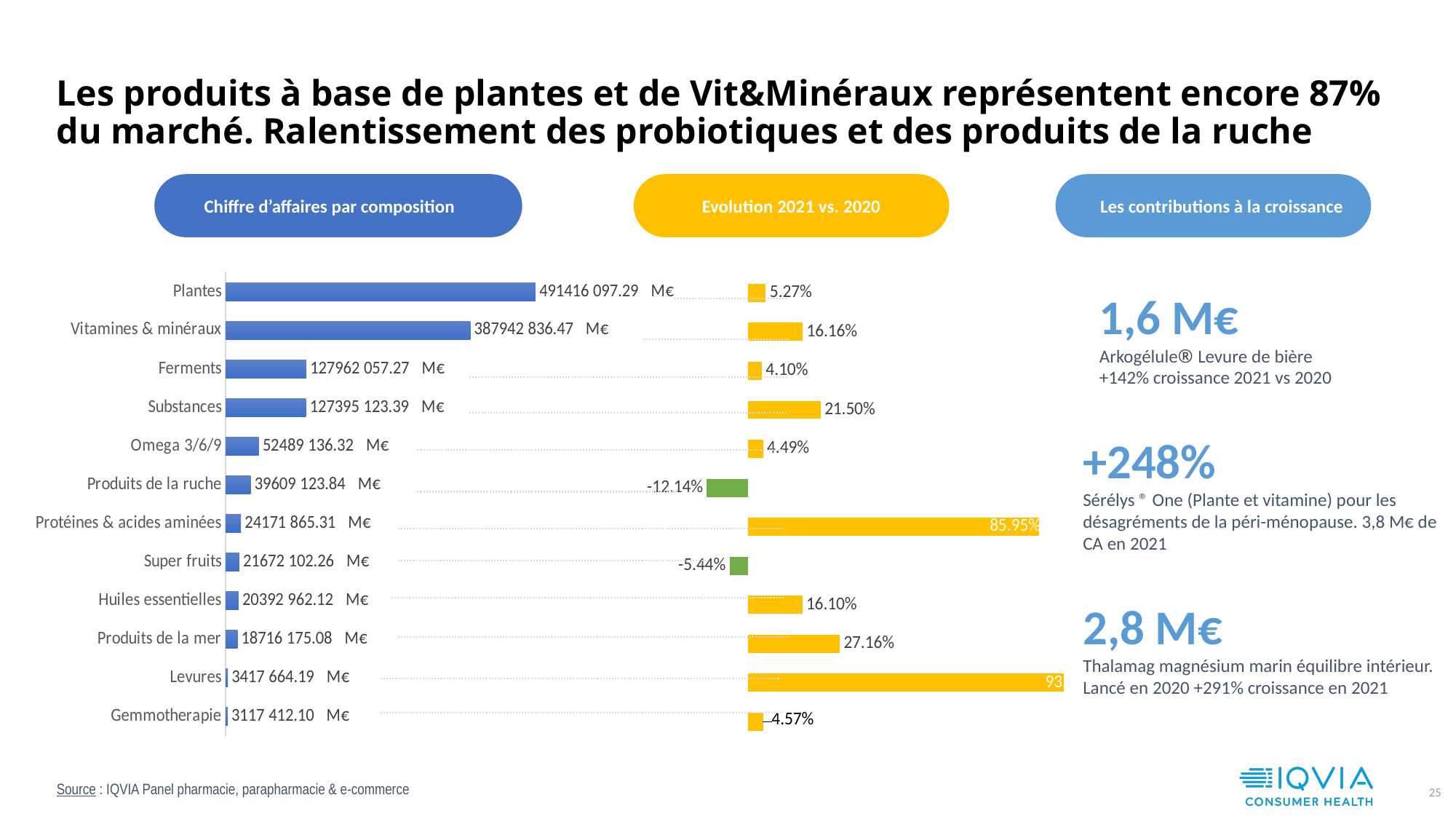
In the 'Evolution 2021 vs. 2020' chart, what is the value for Produits de la ruche? -12.14% In the 'Chiffre d'affaires par composition' chart, which category has the lowest value? Gemmotherapie In the 'Chiffre d'affaires par composition' chart, which category has the highest value? Plantes In the 'Chiffre d'affaires par composition' chart, what is the value for Omega 3/6/9? 52489 136.32 M€ In the 'Chiffre d'affaires par composition' chart, what is the value for Plantes? 491416 097.29 M€ In the 'Evolution 2021 vs. 2020' chart, what colour are the bars for negative values? Green In the 'Evolution 2021 vs. 2020' chart, which is larger: the value for Huiles essentielles or the value for Produits de la mer? Produits de la mer What type of chart is the 'Chiffre d'affaires par composition' chart? Bar chart In the 'Evolution 2021 vs. 2020' chart, which category has the lowest value? Produits de la ruche How many categories are shown in the 'Chiffre d'affaires par composition' chart? 12 In the 'Evolution 2021 vs. 2020' chart, what is the value for Substances? 21.50% In the 'Evolution 2021 vs. 2020' chart, what is the difference between the values for Substances and Plantes? 16.23 percentage points